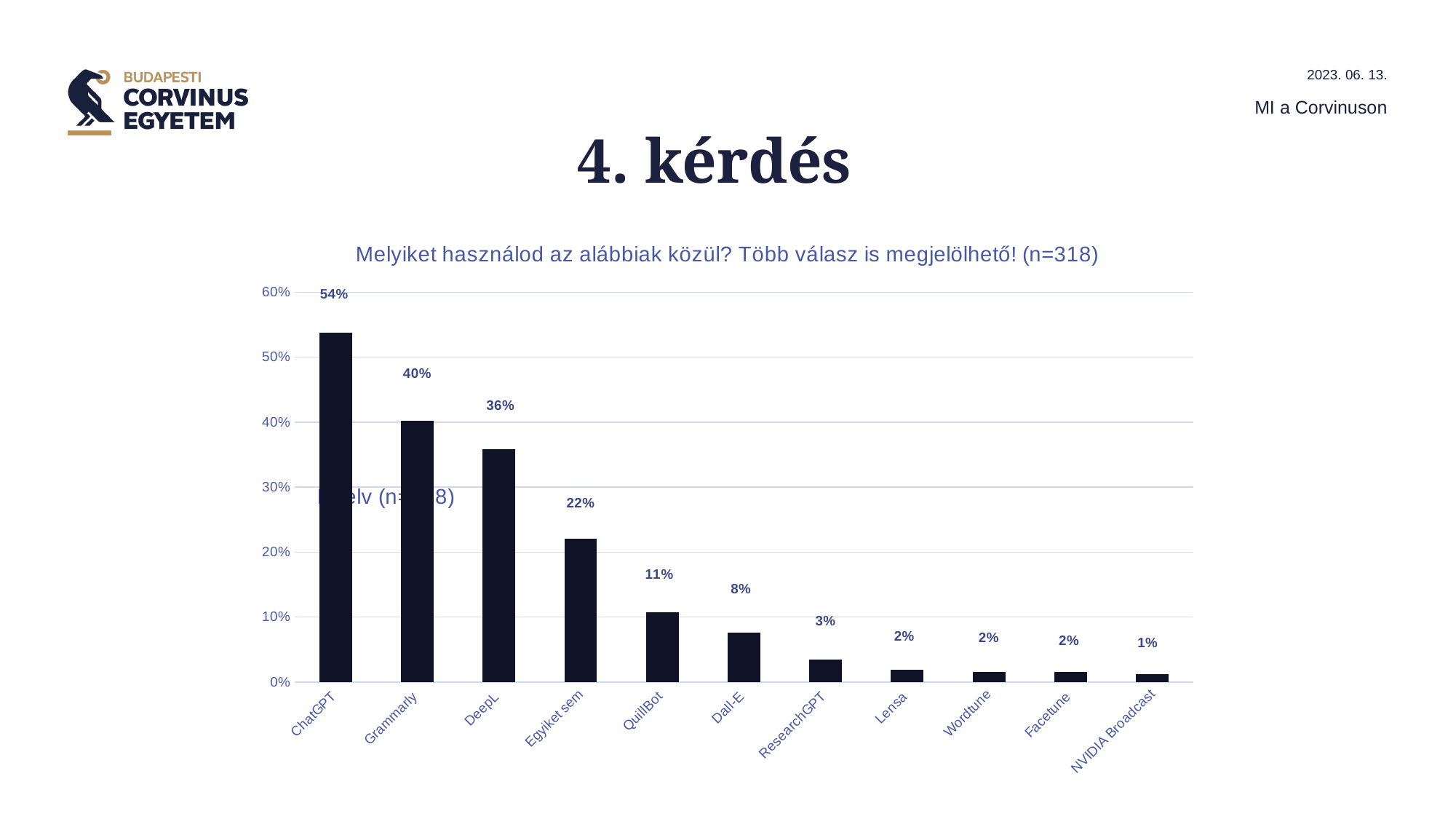
Which category has the highest value? ChatGPT Which category has the lowest value? NVIDIA Broadcast How many categories are shown on the x axis? 11 What is the value for Grammarly? 40% Which is larger, the value for DeepL or the value for Dall-E? DeepL What is the value for Egyiket sem? 22% What is the title of the chart? Melyiket használod az alábbiak közül? Több válasz is megjelölhető! (n=318) What kind of chart is shown on the slide? Bar chart What is the value for QuillBot? 11% What is the difference between the values for DeepL and Egyiket sem? 14% What is the value for ChatGPT? 54% What is the difference between the values for ChatGPT and Grammarly? 14%